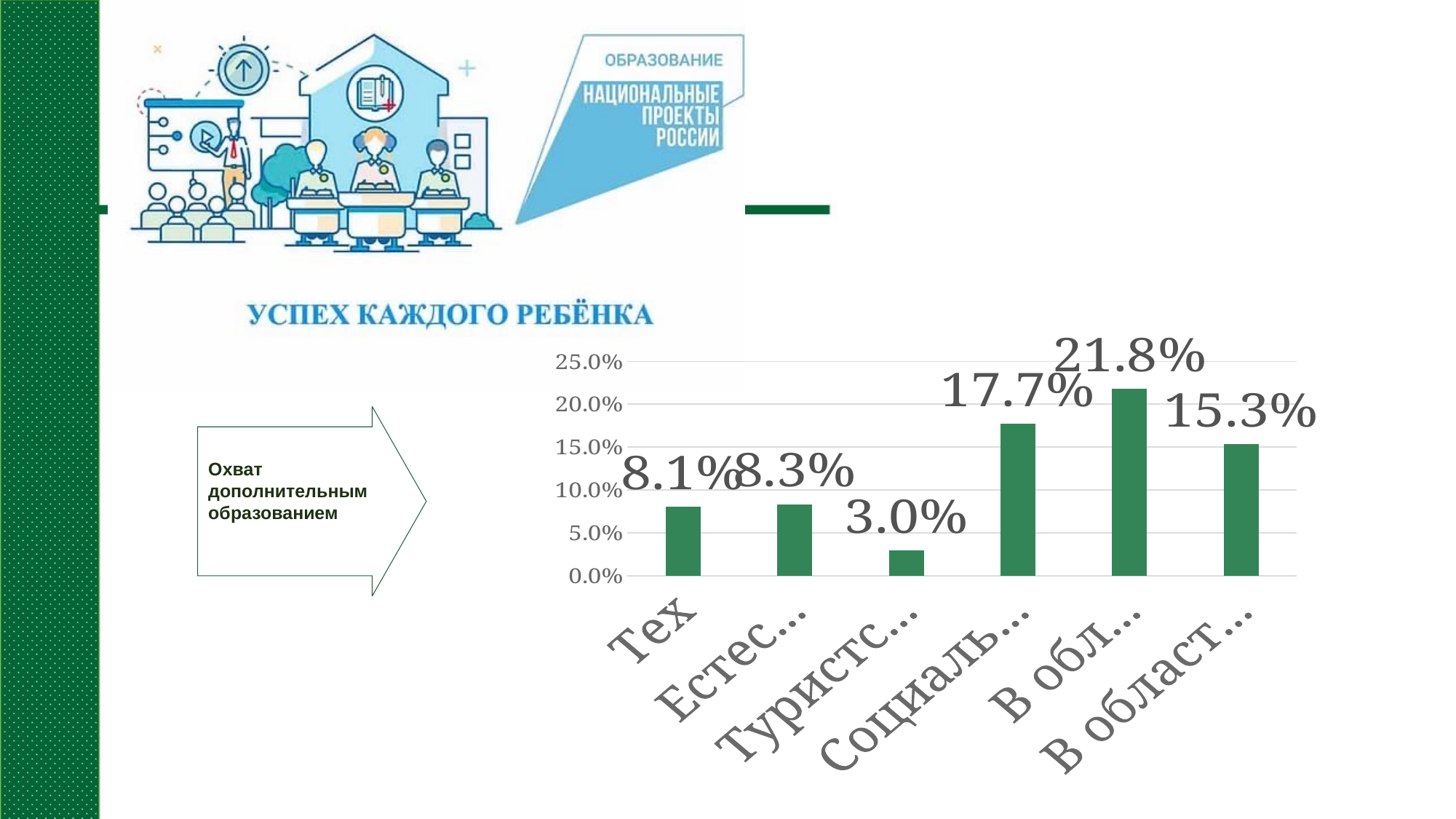
What is the value of the last (sixth) bar on the right? 15.3% What is the highest value shown in the chart? 21.8% What is the value of the third bar from the left ("Туристс...")? 3.0% Is the value of the fourth bar ("Социаль...") greater or less than 15.0%? greater What kind of chart is shown on the slide? bar chart How many bars does the chart show? 6 Which is larger: the value for "Тех" or the value of the second bar ("Естес...")? the second bar (8.3%) What is the lowest value shown in the chart? 3.0% What colour are the bars in the chart? green What is the value for the category "Тех"? 8.1% What is the highest tick label on the vertical axis? 25.0% What is the difference between the highest value (21.8%) and the fourth bar (17.7%)? 4.1 percentage points